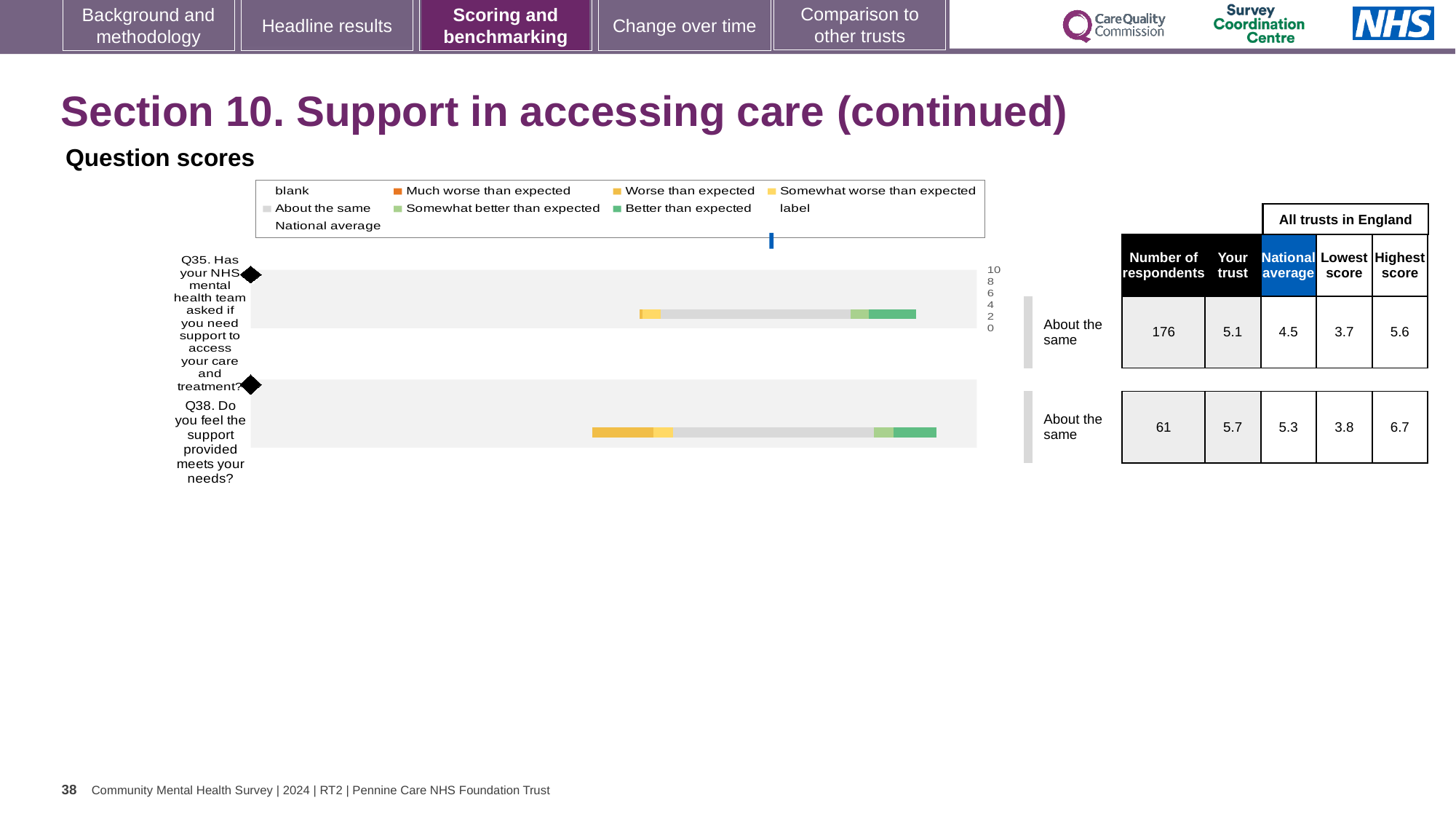
How many respondents answered Q35? 176 What is the difference between the 'Your trust' score and the national average for Q35? 0.6 How many survey questions are plotted as bars in the question scores chart? 2 What is the highest score among all trusts in England for Q38? 6.7 What is the difference in the number of respondents between Q35 and Q38? 115 What benchmark category is shown next to both Q35 and Q38 in the chart? About the same What kind of chart is used to show the question scores on this slide? bar chart Which question has the higher 'Your trust' score, Q35 or Q38? Q38 What is the 'Your trust' score for Q38 (Do you feel the support provided meets your needs?)? 5.7 What is the national average score for Q38? 5.3 What is the lowest score among all trusts in England for Q35? 3.7 What is the 'Your trust' score for Q35 (Has your NHS mental health team asked if you need support to access your care and treatment?)? 5.1